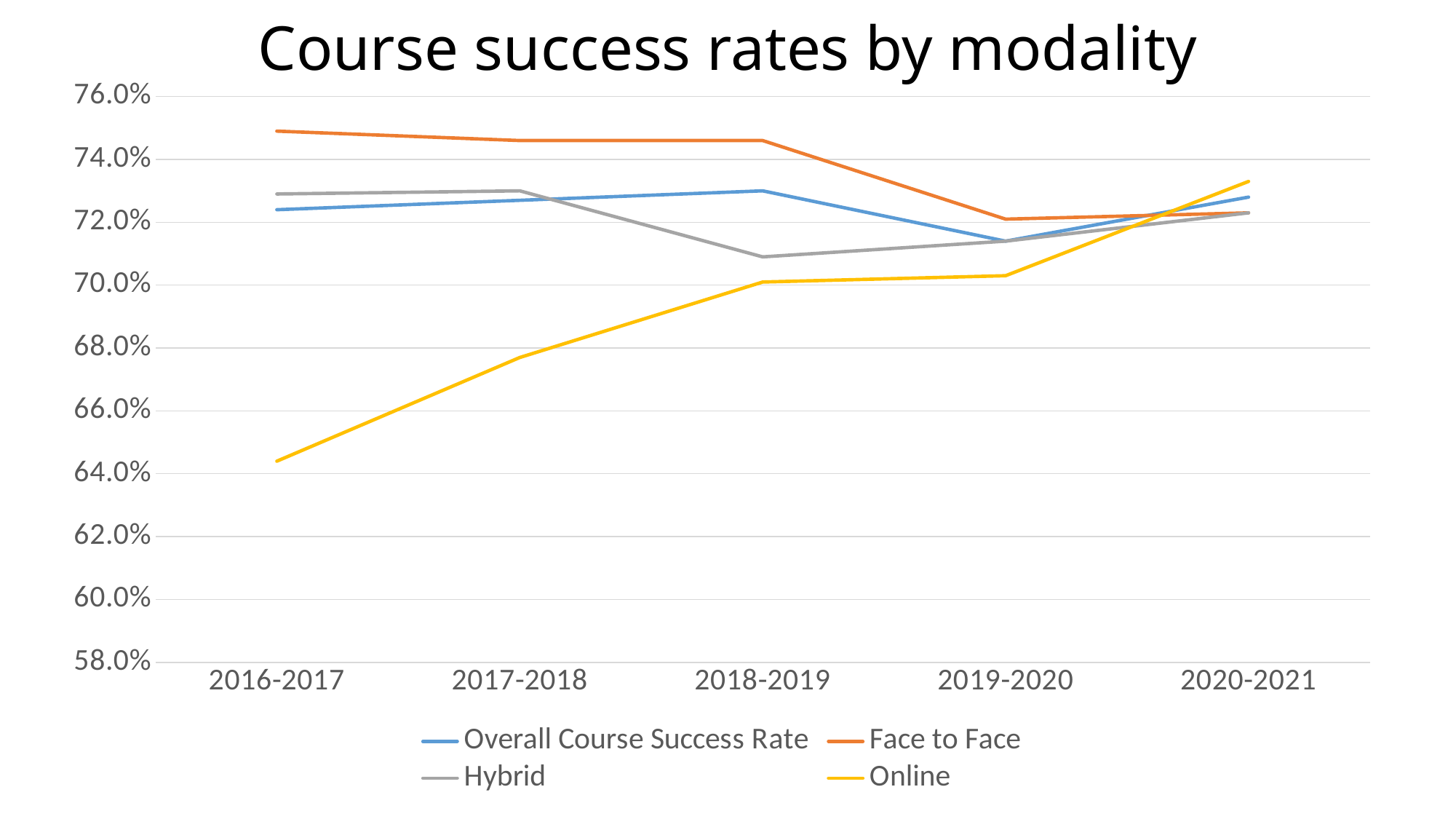
What is the title of the chart? Course success rates by modality Which series has the highest value in 2016-2017? Face to Face Which series has the lowest value in 2016-2017? Online Which series has the highest value in 2020-2021? Online Is the value for Online in 2016-2017 greater or less than 66.0%? less How many series does the legend list? 4 Is the value for Hybrid in 2018-2019 greater or less than 72.0%? less Which is larger in 2018-2019, Face to Face or Online? Face to Face Is the value for Face to Face in 2016-2017 greater or less than 74.0%? greater What kind of chart is shown on the slide? line chart Does the Online series rise or fall from 2016-2017 to 2020-2021? rise How many academic years are shown on the x axis? 5